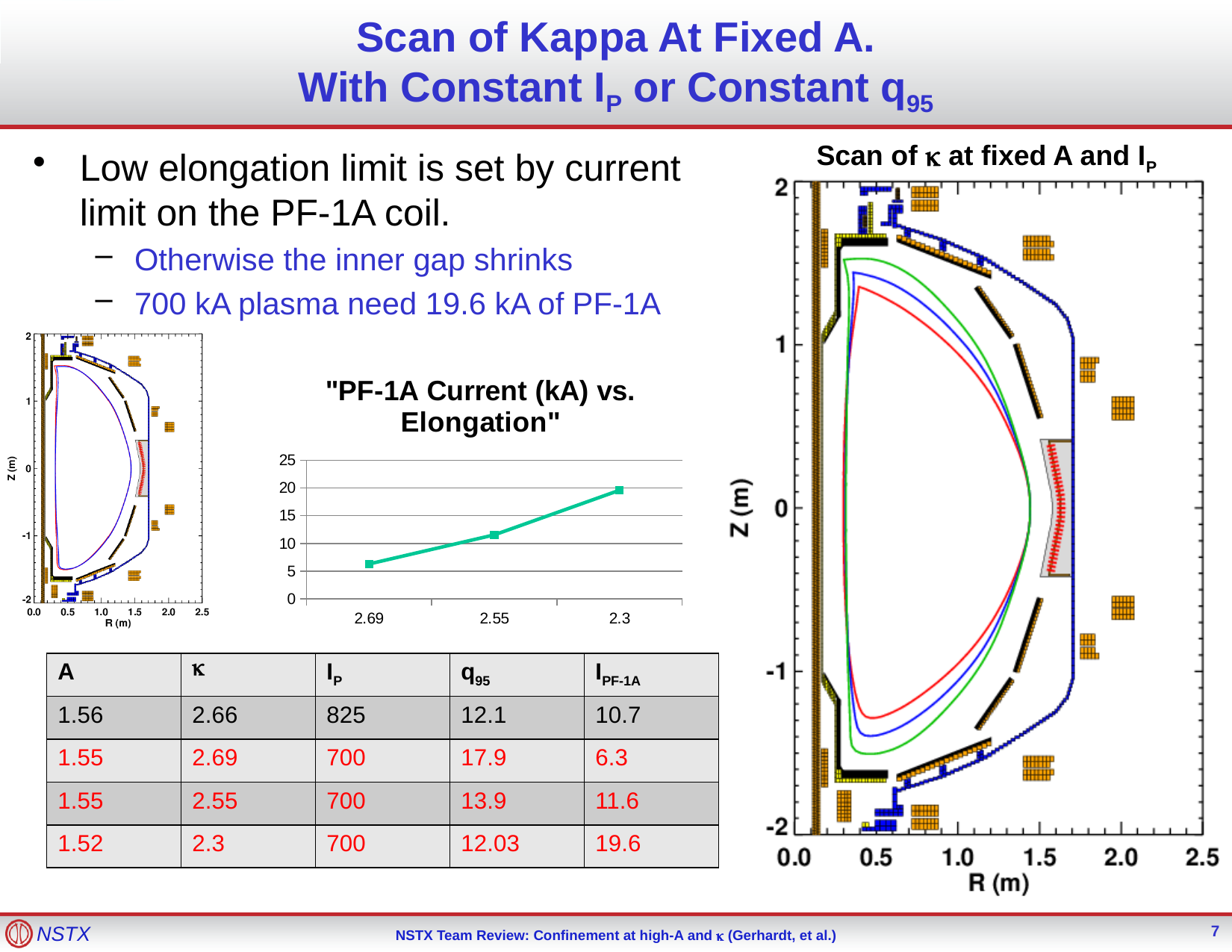
On the "PF-1A Current (kA) vs. Elongation" chart, which elongation value has the highest PF-1A current? 2.3 On the "PF-1A Current (kA) vs. Elongation" chart, is the value at elongation 2.55 greater or less than 10? greater On the "PF-1A Current (kA) vs. Elongation" chart, which elongation value has the lowest PF-1A current? 2.69 What is the highest tick value shown on the y axis of the "PF-1A Current (kA) vs. Elongation" chart? 25 On the "PF-1A Current (kA) vs. Elongation" chart, is the value at elongation 2.3 greater or less than 15? greater What are the three x-axis labels on the "PF-1A Current (kA) vs. Elongation" chart, from left to right? 2.69, 2.55, 2.3 What kind of chart is the "PF-1A Current (kA) vs. Elongation" chart? line chart On the "PF-1A Current (kA) vs. Elongation" chart, is the value at elongation 2.55 greater or less than 15? less How many data points are plotted on the "PF-1A Current (kA) vs. Elongation" chart? 3 On the "PF-1A Current (kA) vs. Elongation" chart, which has the larger value: elongation 2.55 or elongation 2.3? 2.3 On the "PF-1A Current (kA) vs. Elongation" chart, do the values rise or fall moving from left to right along the x axis? rise